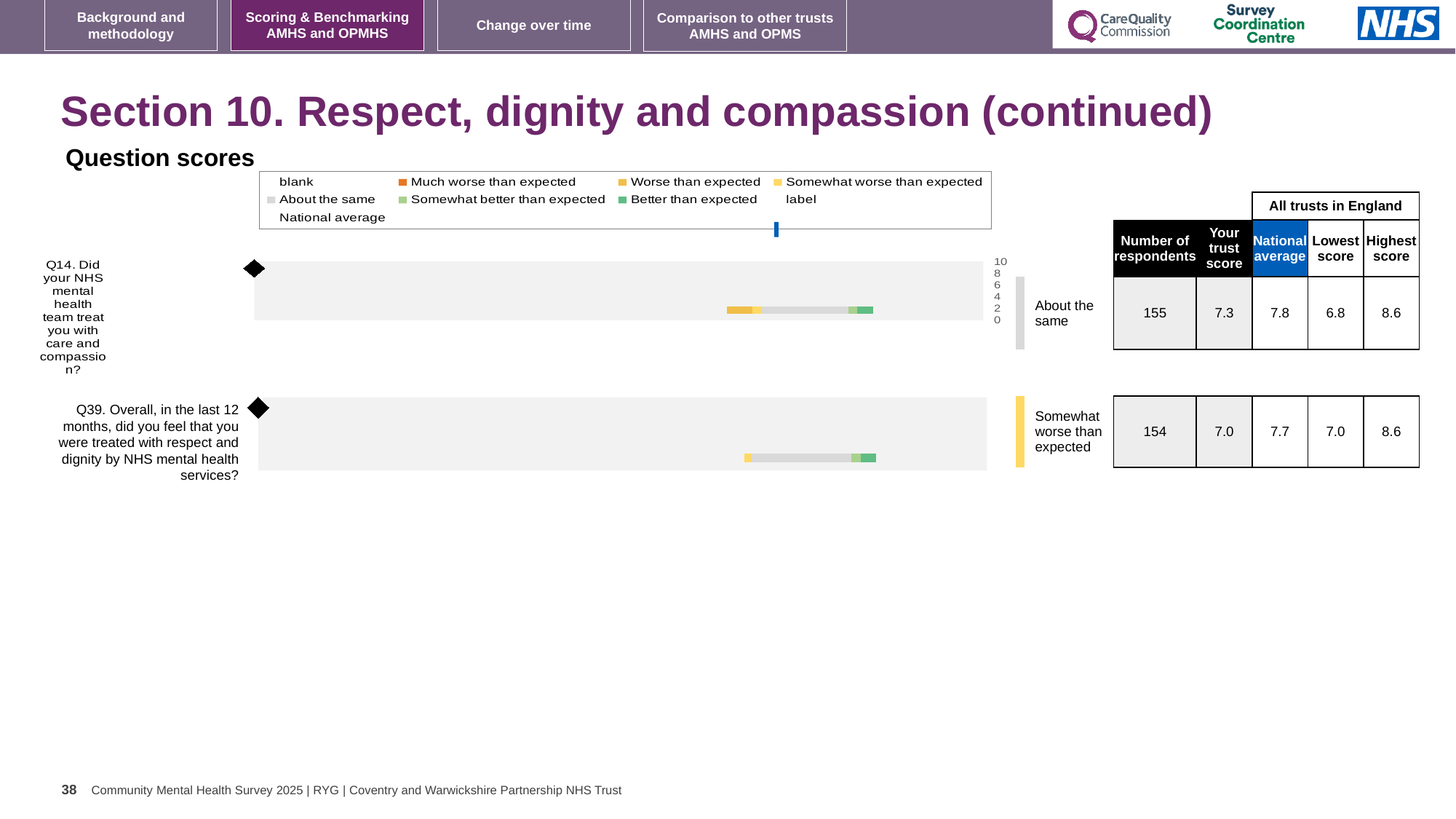
What is the number of respondents for Q14? 155 What is the difference between the national average and the trust score for Q14? 0.5 What is the national average for Q39 (treated with respect and dignity)? 7.7 Which question has the higher trust score, Q14 or Q39? Q14 How many entries does the chart legend list? 9 What is the lowest score across all trusts in England for Q39? 7.0 What kind of chart is shown under the heading "Question scores"? bar chart What benchmark category is the trust's score for Q39 placed in? Somewhat worse than expected What is the trust score for Q14 (care and compassion)? 7.3 What is the highest score across all trusts in England for Q14? 8.6 What benchmark category is the trust's score for Q14 placed in? About the same How many survey questions are plotted in the chart? 2